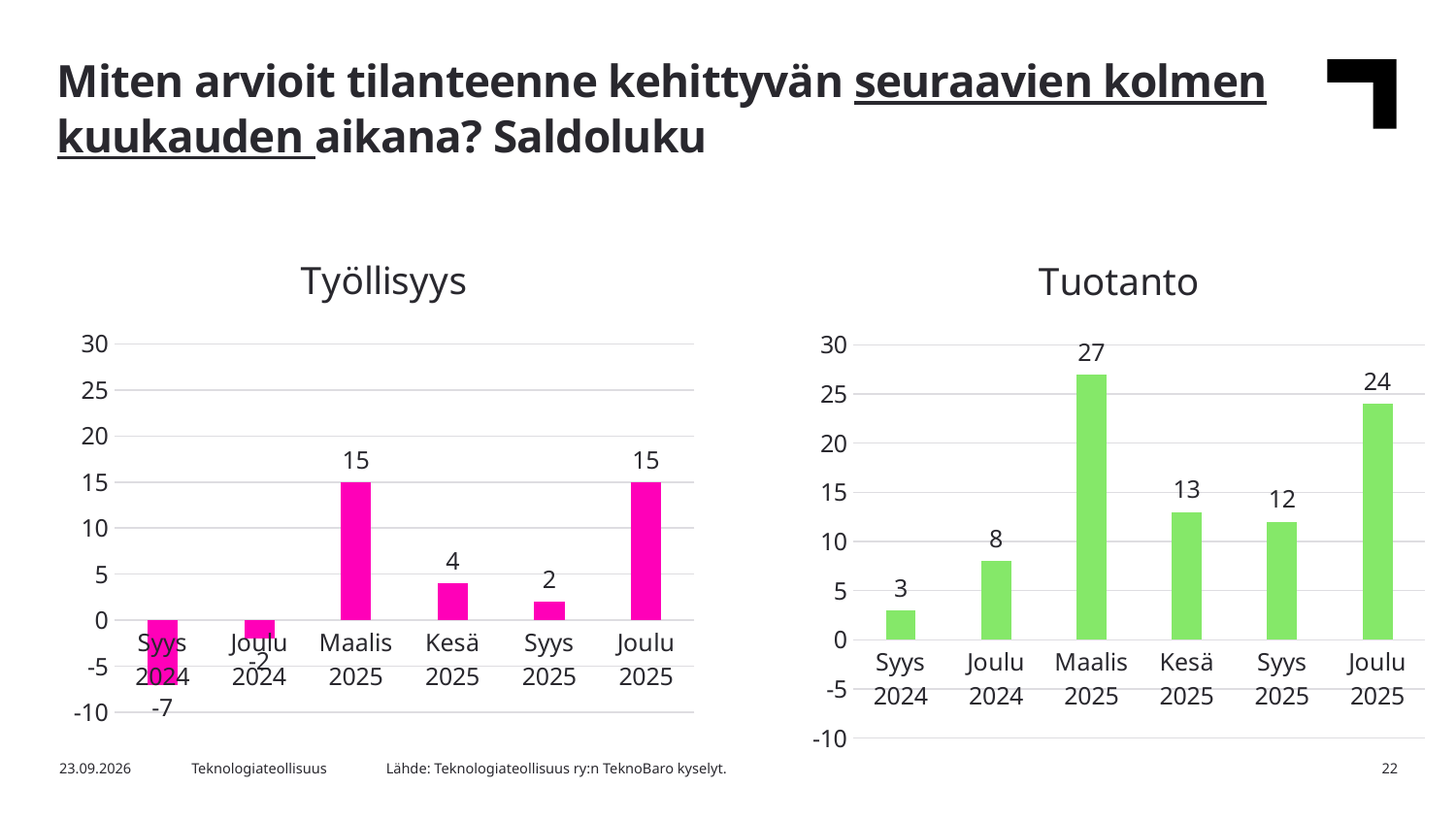
In the Työllisyys chart, what is the difference between the values for Maalis 2025 and Syys 2025? 13 In the Tuotanto chart, which category has the lowest value? Syys 2024 In the Työllisyys chart, what is the value for Syys 2024? -7 What colour are the bars in the Työllisyys chart? Pink In the Tuotanto chart, which category has the highest value? Maalis 2025 In the Tuotanto chart, what is the difference between the values for Maalis 2025 and Joulu 2025? 3 In the Työllisyys chart, which category has the lowest value? Syys 2024 In the Työllisyys chart, how many categories are shown on the x axis? 6 What type of chart is the Tuotanto chart? Bar chart In the Työllisyys chart, what is the value for Kesä 2025? 4 In the Tuotanto chart, what is the value for Joulu 2024? 8 In the Tuotanto chart, is the value for Kesä 2025 larger than the value for Syys 2025? Yes